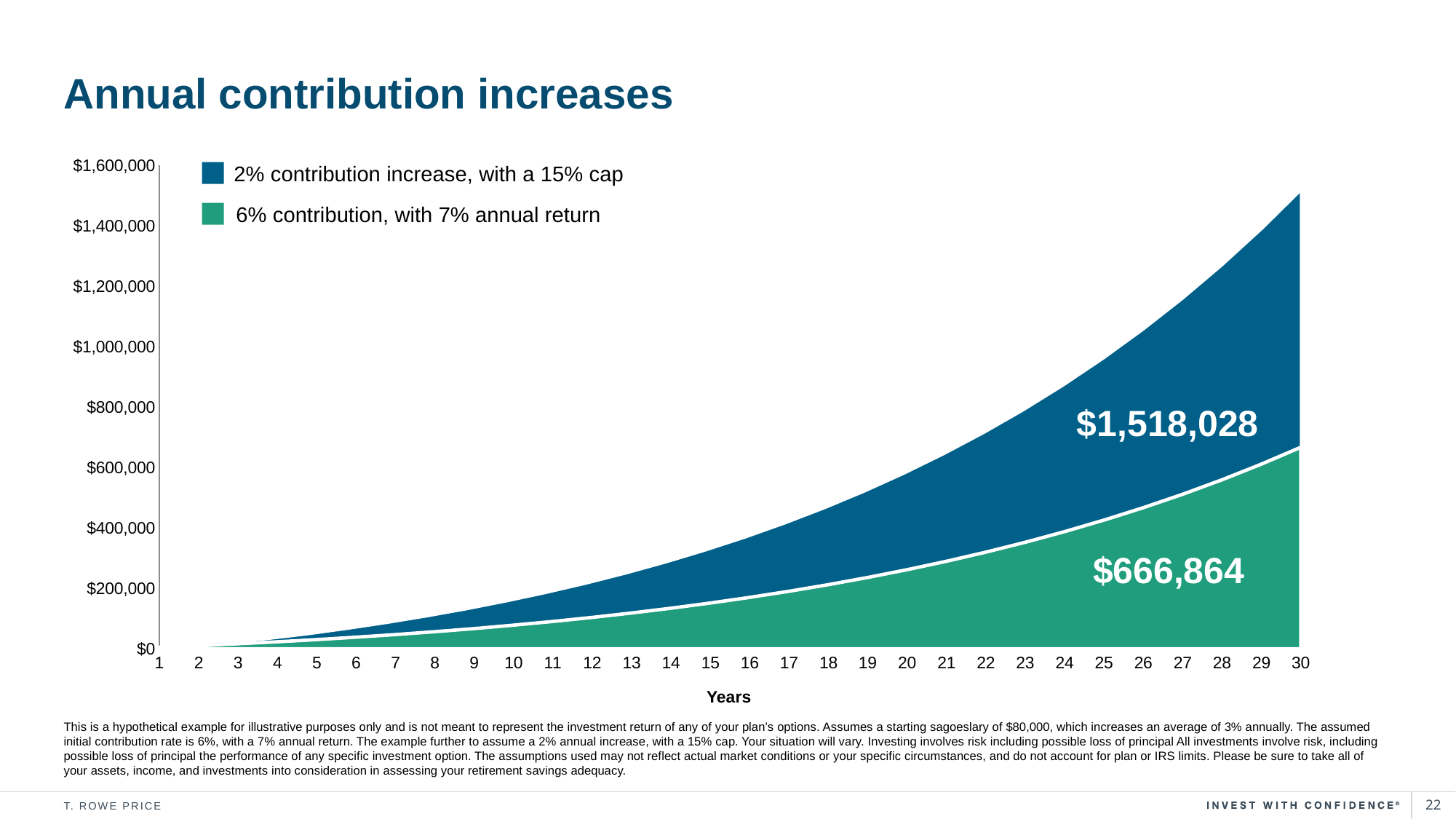
Do the values rise or fall as the years increase along the x axis? rise What kind of chart is shown on the slide? area chart Which series has the larger value at year 30? 2% contribution increase, with a 15% cap Is the value for the 2% contribution increase, with a 15% cap series at year 20 greater or less than $800,000? less What is the label on the x axis? Years How many series does the legend list? 2 What is the value shown for the 6% contribution, with 7% annual return series at year 30? $666,864 What is the value shown for the 2% contribution increase, with a 15% cap series at year 30? $1,518,028 Is the value for the 6% contribution, with 7% annual return series at year 30 greater or less than $600,000? greater What is the difference between the two labelled values at year 30? $851,164 What is the title of the chart? Annual contribution increases How many years are shown on the x axis? 30